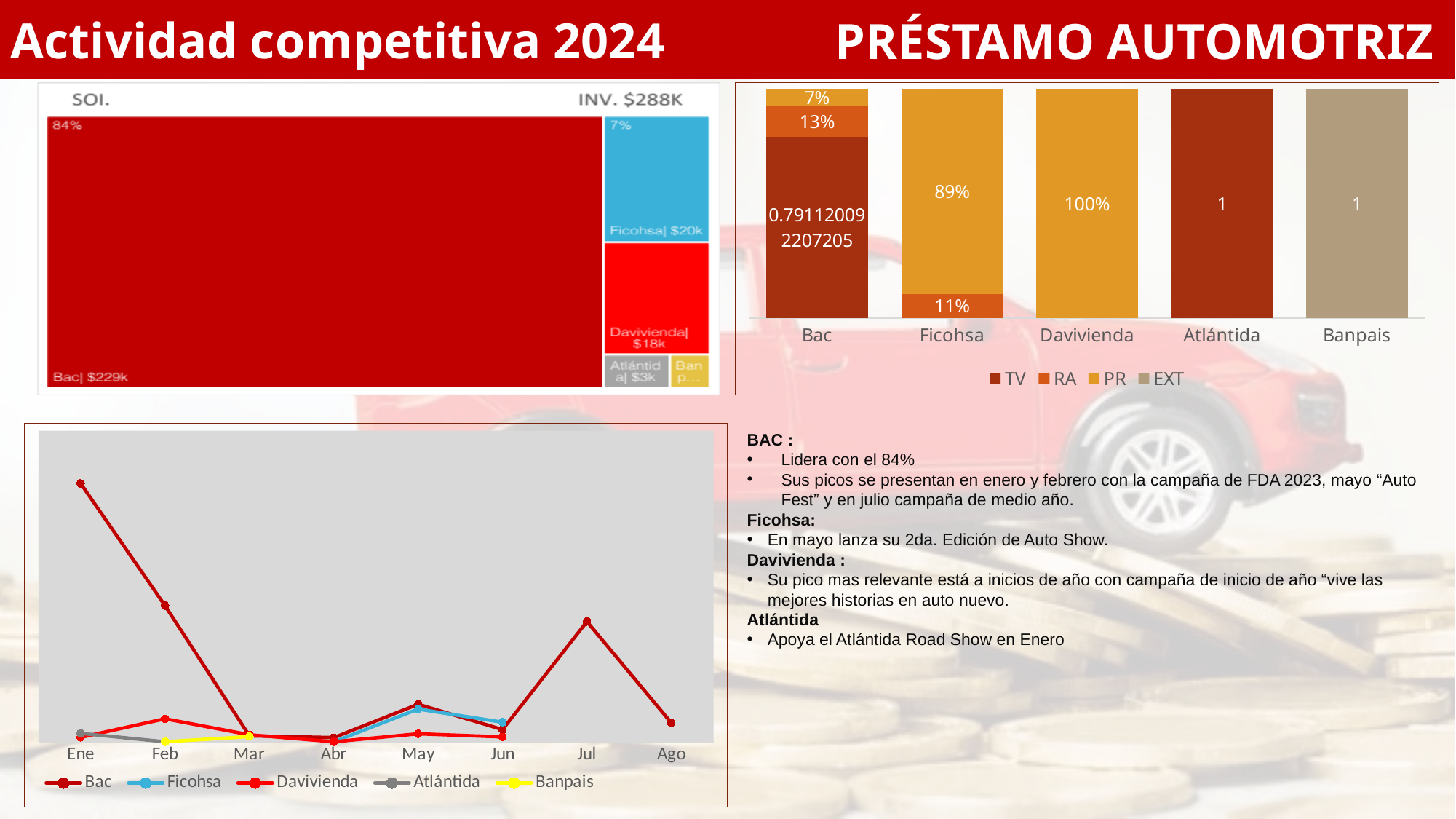
What kind of chart is the bottom-left chart with months on the x axis? Line chart In the bottom-left line chart, which series has the highest value in Ene? Bac In the top-right stacked bar chart, how many banks are shown on the x axis? 5 In the top-left treemap chart, what is the value shown for Davivienda? $18k In the top-right stacked bar chart, what is the RA value for Bac? 13% In the top-left treemap chart, what share of the total does Bac hold? 84% In the top-left treemap chart, what total investment (INV.) is shown in the header? $288K In the top-right stacked bar chart, what is the PR value for Ficohsa? 89% In the top-right stacked bar chart, what is the PR value for Davivienda? 100% In the top-right stacked bar chart, how many series does the legend list? 4 In the top-left treemap chart, what is the value shown for Ficohsa? $20k In the top-left treemap chart, what is the value shown for Bac? $229k